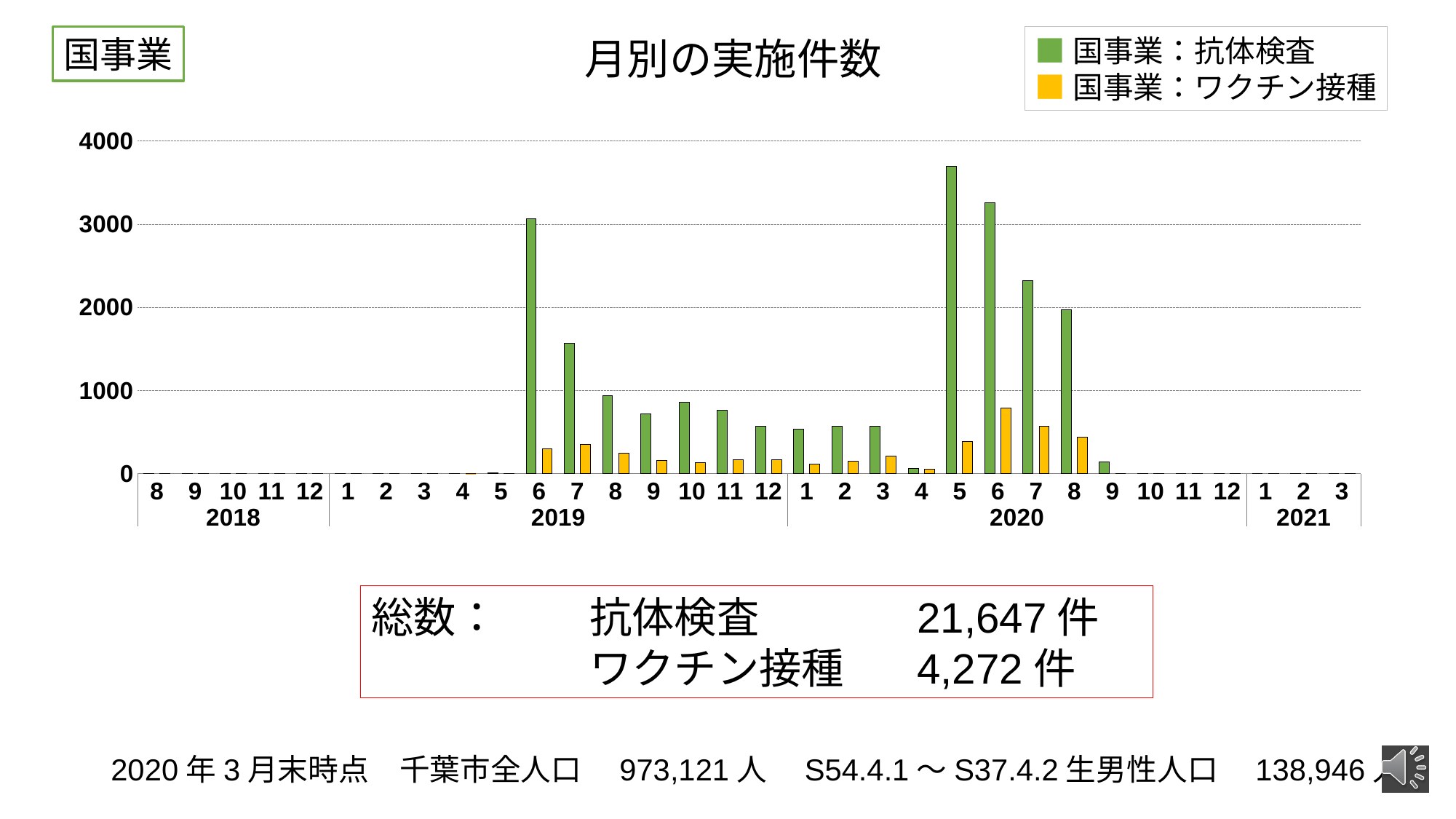
Do the 国事業：抗体検査 bars rise or fall from 2020年5月 to 2020年9月? fall What kind of chart is shown on the slide? bar chart Is the 国事業：ワクチン接種 value for 2020年6月 greater or less than 1000? less Is the 国事業：抗体検査 value for 2020年5月 greater or less than 3000? greater What is the title of the chart? 月別の実施件数 How many months are shown on the x axis? 32 In which month is the 国事業：ワクチン接種 (yellow) bar highest? 2020年6月 Which series is shown in yellow in the legend? 国事業：ワクチン接種 Is the 国事業：抗体検査 value for 2019年6月 greater or less than 2000? greater In which month is the 国事業：抗体検査 (green) bar highest? 2020年5月 How many series does the legend list? 2 Which is larger: the 国事業：抗体検査 value for 2020年5月 or for 2019年6月? 2020年5月